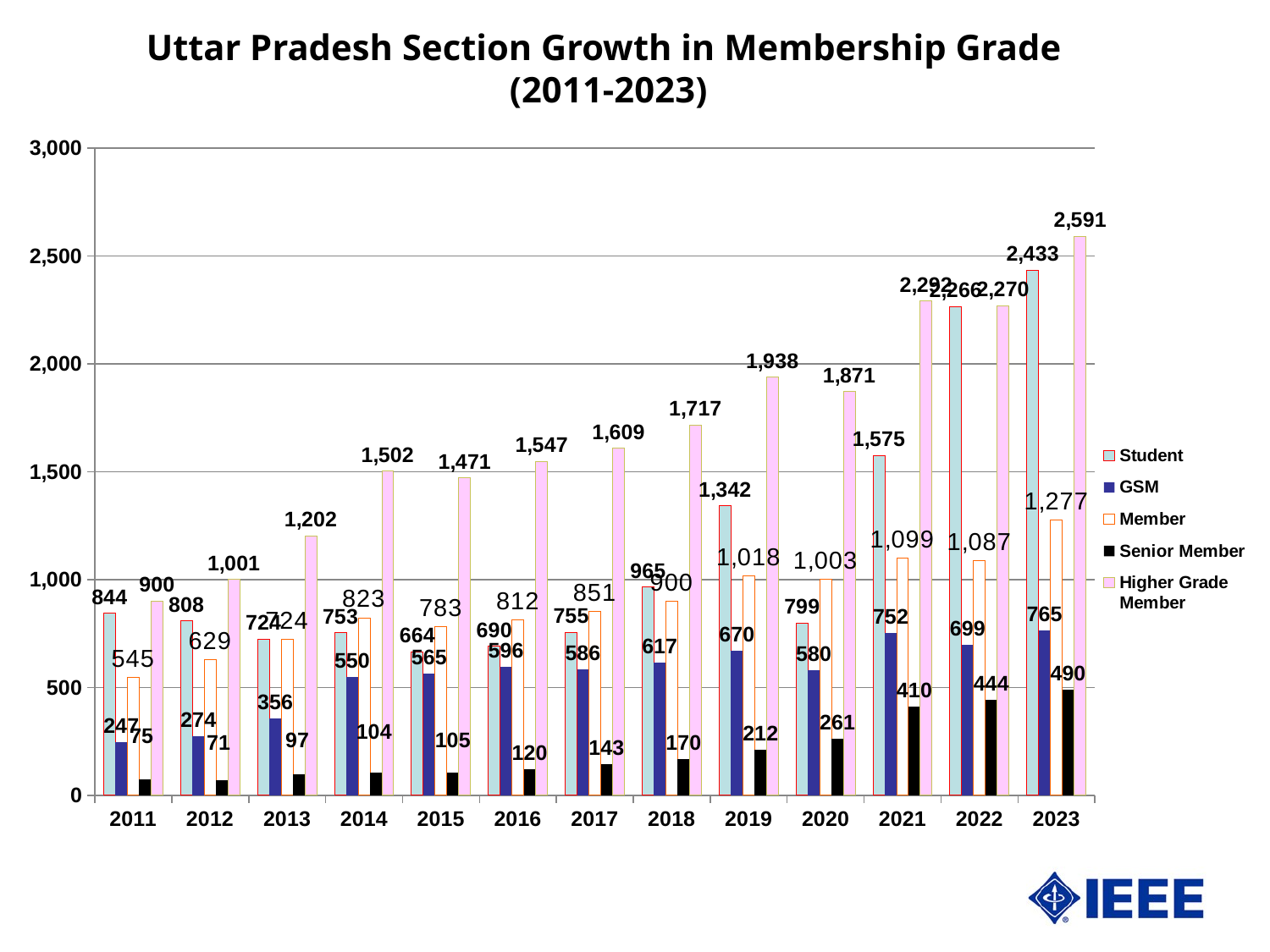
Does the Higher Grade Member value rise or fall from 2011 to 2019? Rise In 2018, which is larger: the Student value or the Member value? Student What is the Higher Grade Member value for 2023? 2,591 What is the Senior Member value for 2019? 212 Is the Student value for 2020 greater or less than 1,000? less How many series does the legend list? 5 What is the GSM value for 2014? 550 In which year is the Senior Member value highest? 2023 In which year is the Higher Grade Member value lowest? 2011 What kind of chart is shown on the slide? Bar chart What is the difference between the Student value in 2023 and the Student value in 2011? 1,589 How many years are shown on the x axis? 13